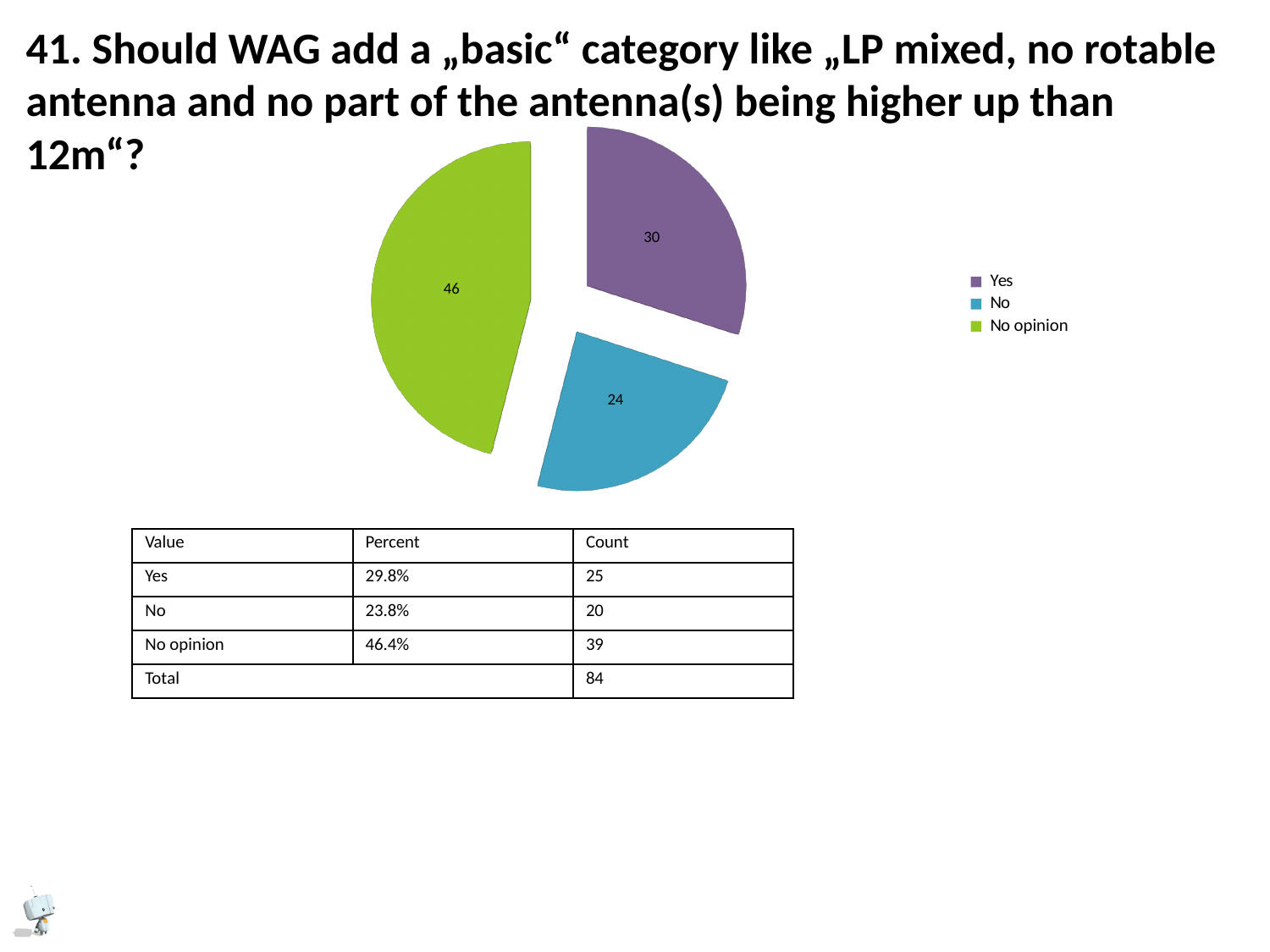
What is the difference between the labelled values for No opinion and Yes? 16 How many slices does the pie chart have? 3 Which slice is larger, Yes or No? Yes What kind of chart is shown on the slide? pie chart How many entries does the legend list? 3 What value is labelled on the pie slice for No? 24 What colour is the No opinion slice in the pie chart? green What is the difference between the labelled values for Yes and No? 6 What value is labelled on the pie slice for Yes? 30 Which category has the largest slice of the pie? No opinion Which category has the smallest slice of the pie? No What value is labelled on the pie slice for No opinion? 46